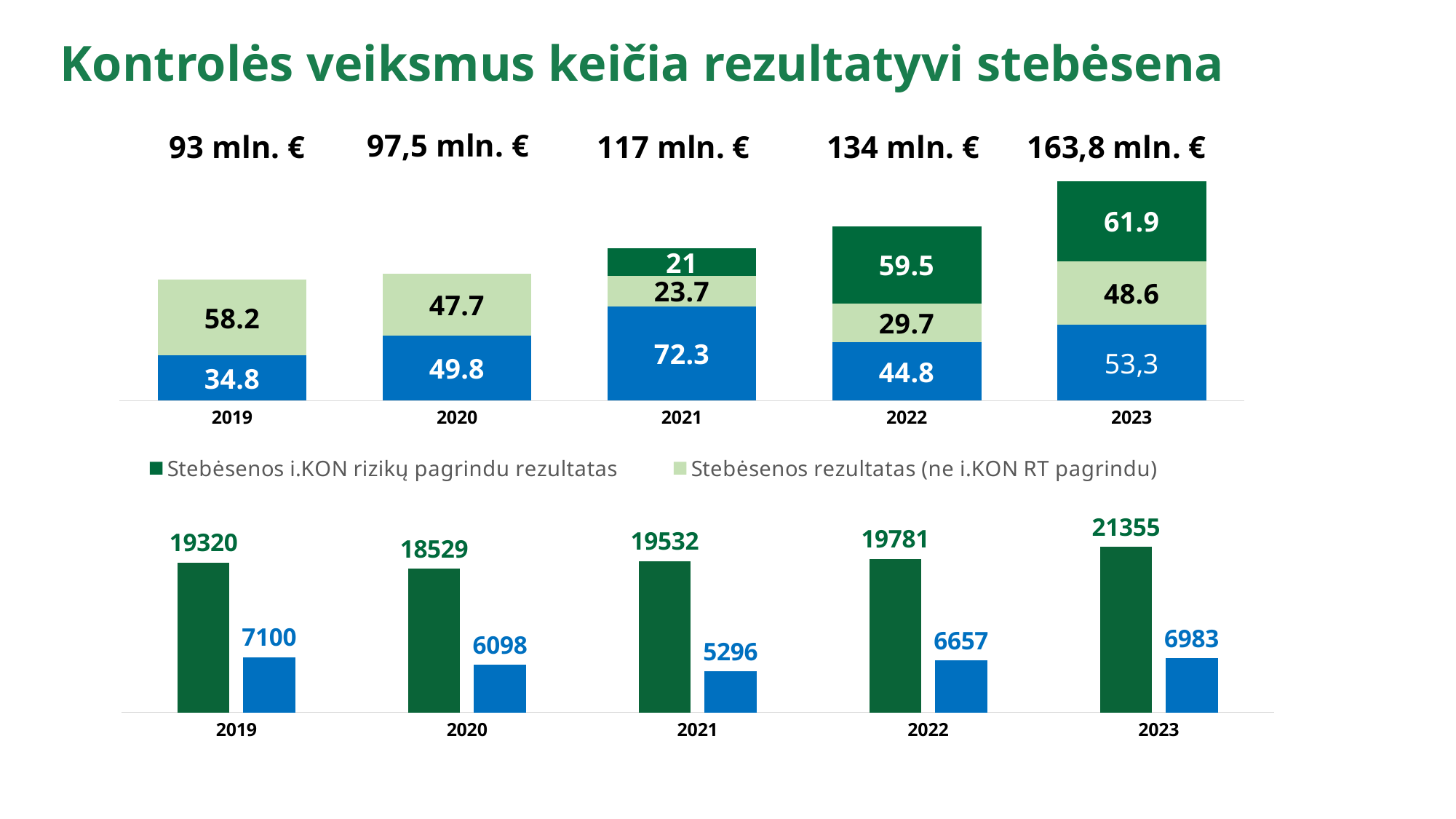
In the top chart for 2021, which is larger: the blue segment or the light green segment? The blue segment (72.3) In the bottom chart, what is the difference between the dark green bar and the blue bar for 2023? 14372 In the top chart, what is the difference between the light green segment and the blue segment for 2019? 23.4 Do the totals printed above the bars in the top chart rise or fall from 2019 to 2023? Rise In the bottom chart, which year has the highest dark green bar? 2023 In the bottom chart, what is the value of the blue bar for 2022? 6657 In the top chart, what is the value of the 'Stebėsenos i.KON rizikų pagrindu rezultatas' segment for 2022? 59.5 In the bottom chart, which year has the lowest blue bar? 2021 How many years are shown on the x axis of the bottom chart? 5 In the top chart, what is the value of the 'Stebėsenos rezultatas (ne i.KON RT pagrindu)' segment for 2020? 47.7 In the top chart, what total is printed above the 2023 bar? 163,8 mln. € How many series does the legend of the top chart list? 2